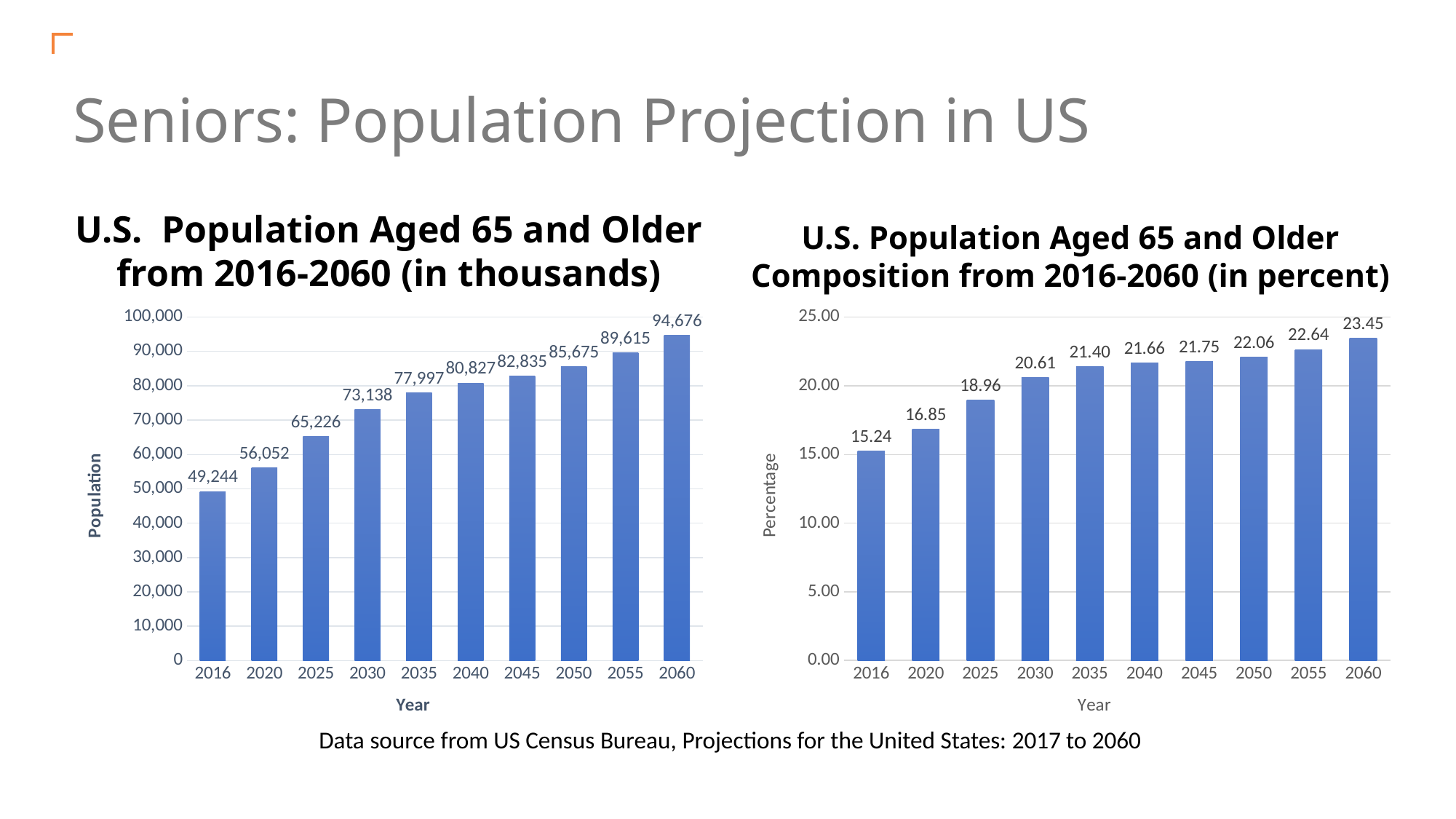
What is the y-axis label of the right chart (in percent)? Percentage In the right chart (Composition in percent), what is the percentage for 2045? 21.75 In the right chart (in percent), which year has the lowest percentage? 2016 In the left chart (in thousands), is the value for 2050 greater or less than 80,000? greater In the right chart (in percent), what is the difference between the values for 2025 and 2020? 2.11 In the left chart (in thousands), which year has the highest population value? 2060 In the left chart (U.S. Population Aged 65 and Older from 2016-2060), what is the population value for 2030? 73,138 What kind of chart is the left chart (U.S. Population Aged 65 and Older from 2016-2060)? Bar chart In the right chart (in percent), do the values rise or fall from 2016 to 2060? Rise In the left chart (in thousands), which is larger, the value for 2040 or the value for 2035? 2040 How many years are shown on the x axis of the right chart (in percent)? 10 In the left chart (in thousands), what is the difference between the values for 2060 and 2016? 45,432